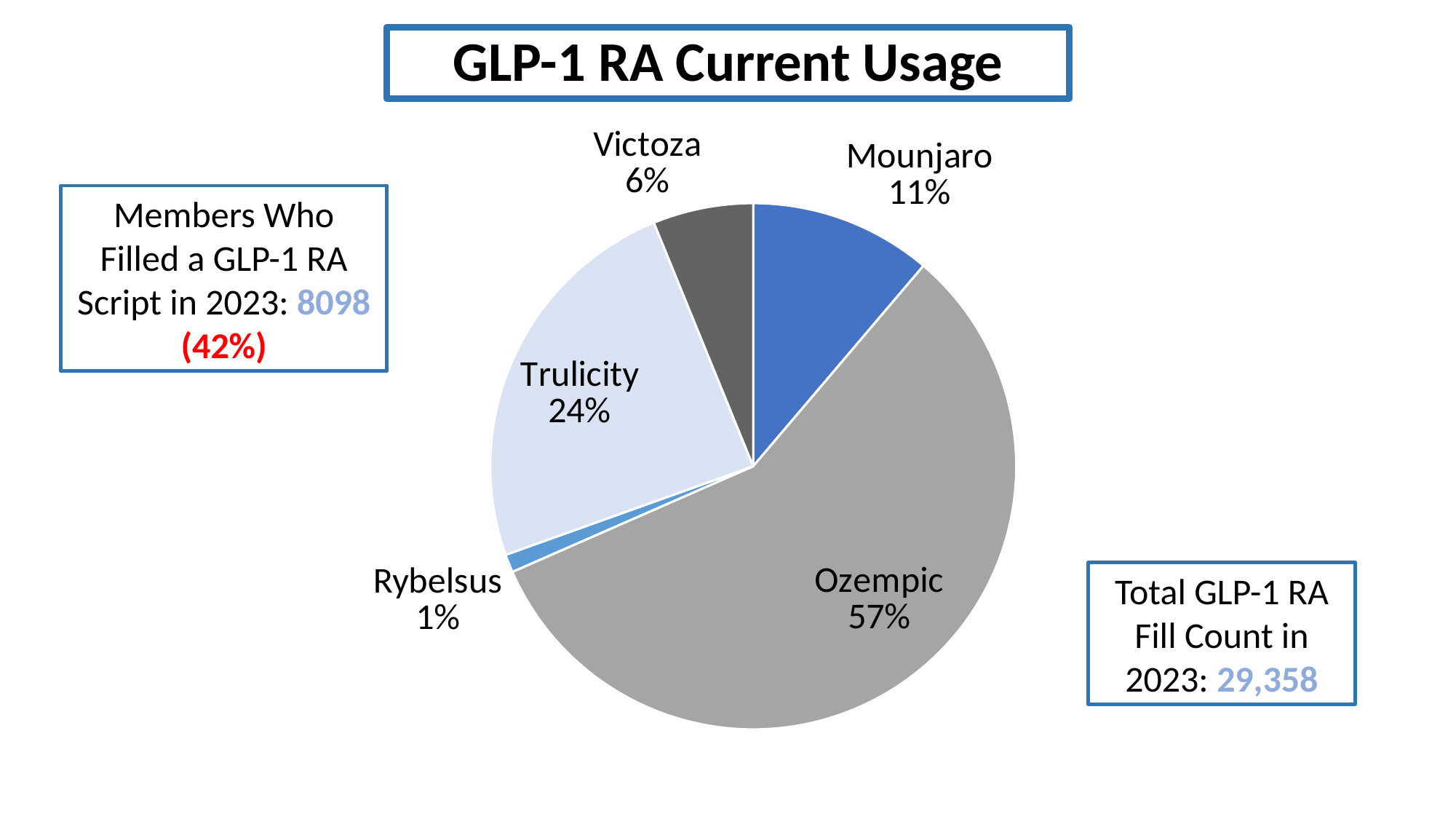
What is the value shown for Mounjaro? 11% What share of the pie does Ozempic have? 57% What is the title of the chart? GLP-1 RA Current Usage What is the value shown for Rybelsus? 1% What is the difference in percentage points between Ozempic and Trulicity? 33 What kind of chart is shown on the slide? Pie chart Which drug has the largest slice of the pie? Ozempic How many drugs are shown in the pie chart? 5 What is the value shown for Victoza? 6% What share of the pie does Trulicity have? 24% Which drug has the smallest slice of the pie? Rybelsus Which has a larger share, Mounjaro or Victoza? Mounjaro